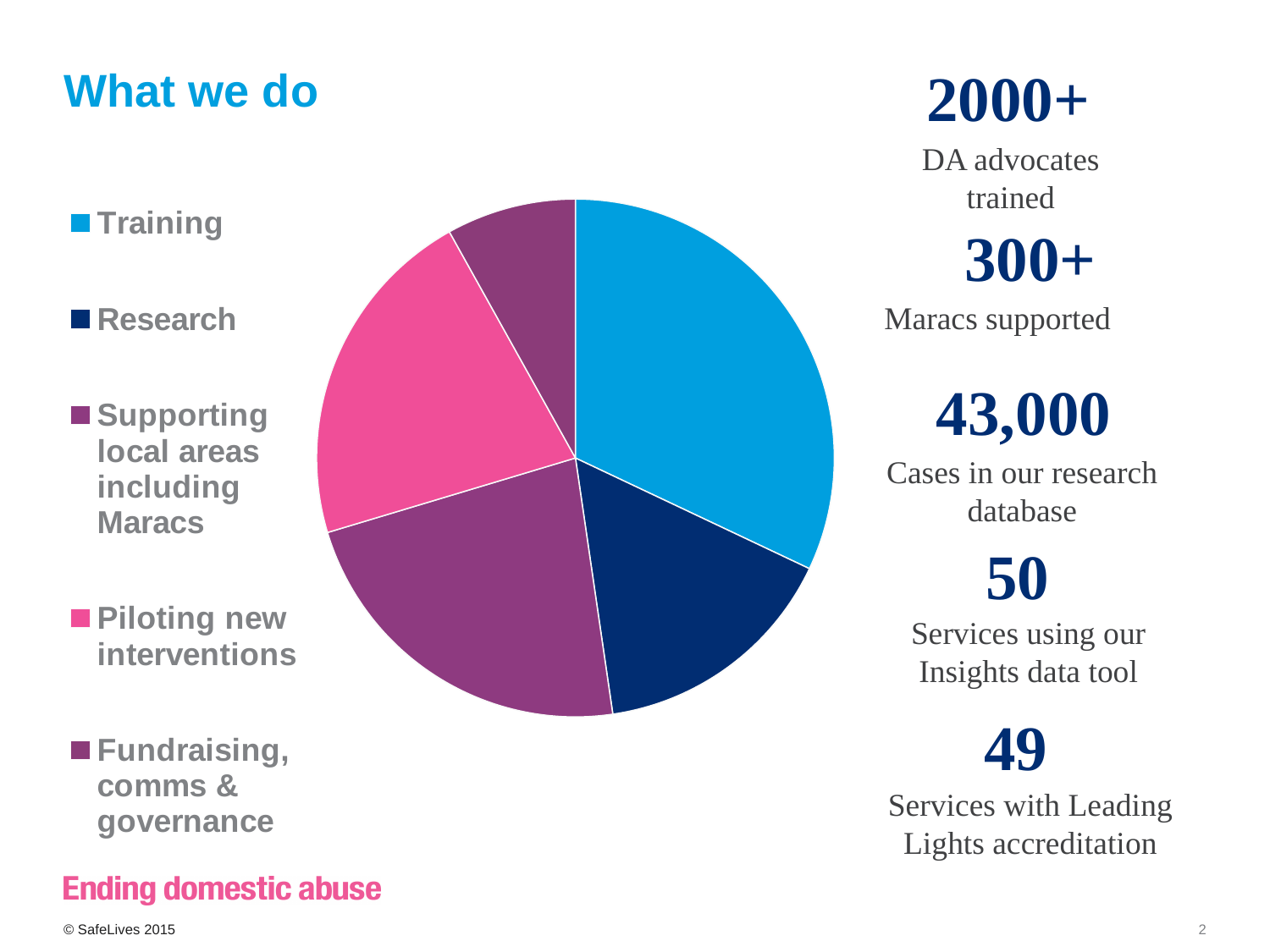
Which category has the largest slice of the pie chart? Training What is the title of the slide containing the pie chart? What we do Which category has the smallest slice of the pie chart? Fundraising, comms & governance What colour is the Training slice in the pie chart? light blue Which slice is larger in the pie chart, Training or Research? Training How many entries does the legend of the pie chart list? 5 What kind of chart is shown on the slide? pie chart Which slice is larger in the pie chart, Supporting local areas including Maracs or Research? Supporting local areas including Maracs How many slices does the pie chart have? 5 Which slice is larger in the pie chart, Piloting new interventions or Fundraising, comms & governance? Piloting new interventions